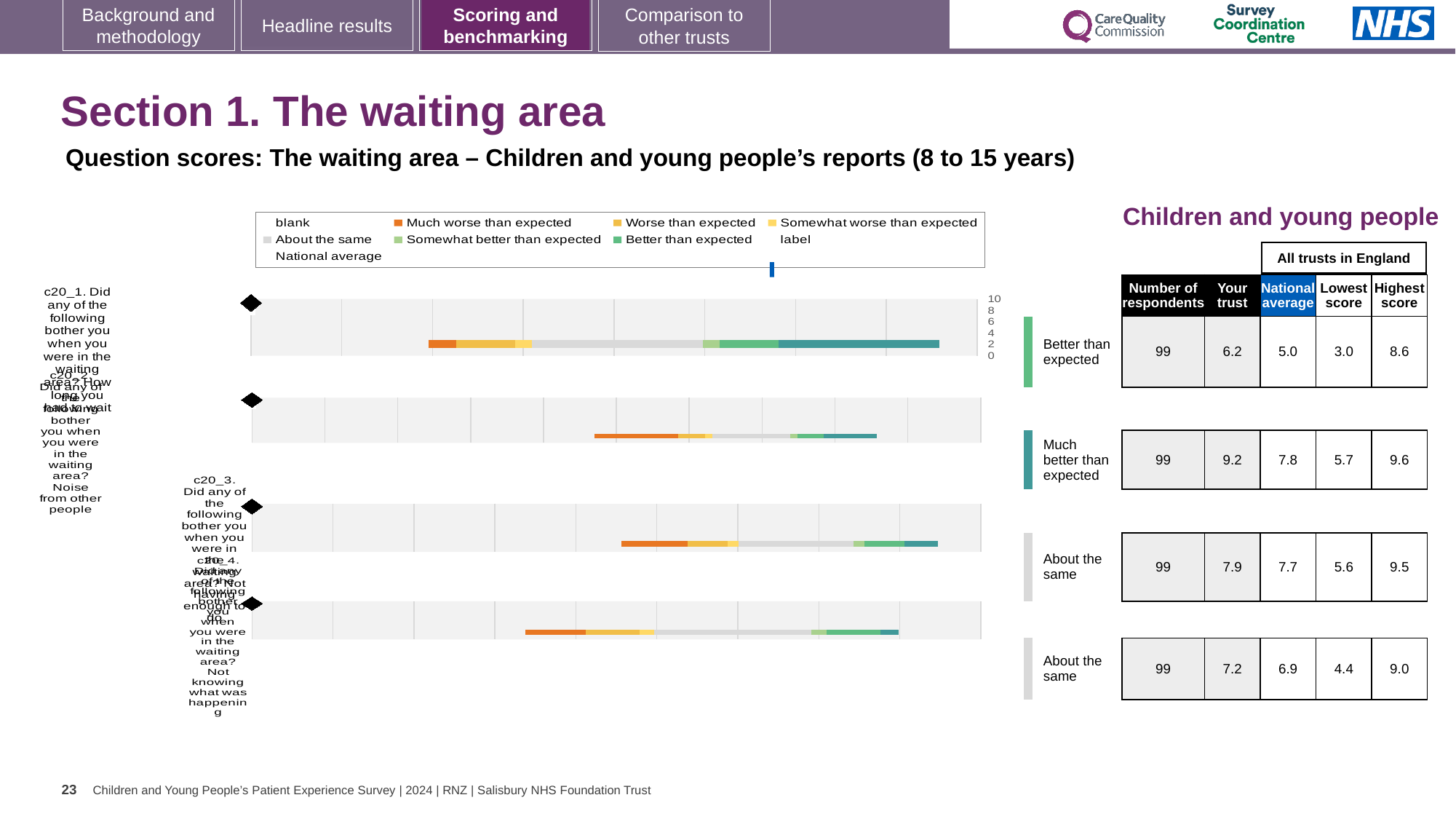
In the table, what is the lowest score for the fourth question (c20_4)? 4.4 What is the difference between the 'Your trust' score and the national average for the second question (c20_2)? 1.4 How many respondents are listed for each question in the table? 99 What is the maximum value shown on the score axis of the bar charts? 10 How many question bar charts are shown on the slide? 4 Is the 'Your trust' score for the first question (c20_1) higher or lower than the national average? higher What kind of chart is used to show the question scores on this slide? bar chart In the table, what is the 'Your trust' score for the first question (c20_1)? 6.2 Which legend entry is shown in orange? Much worse than expected Which question has the highest 'Your trust' score in the table? c20_2 In the table, what is the highest score for the third question (c20_3)? 9.5 In the table, what is the national average for the second question (c20_2)? 7.8